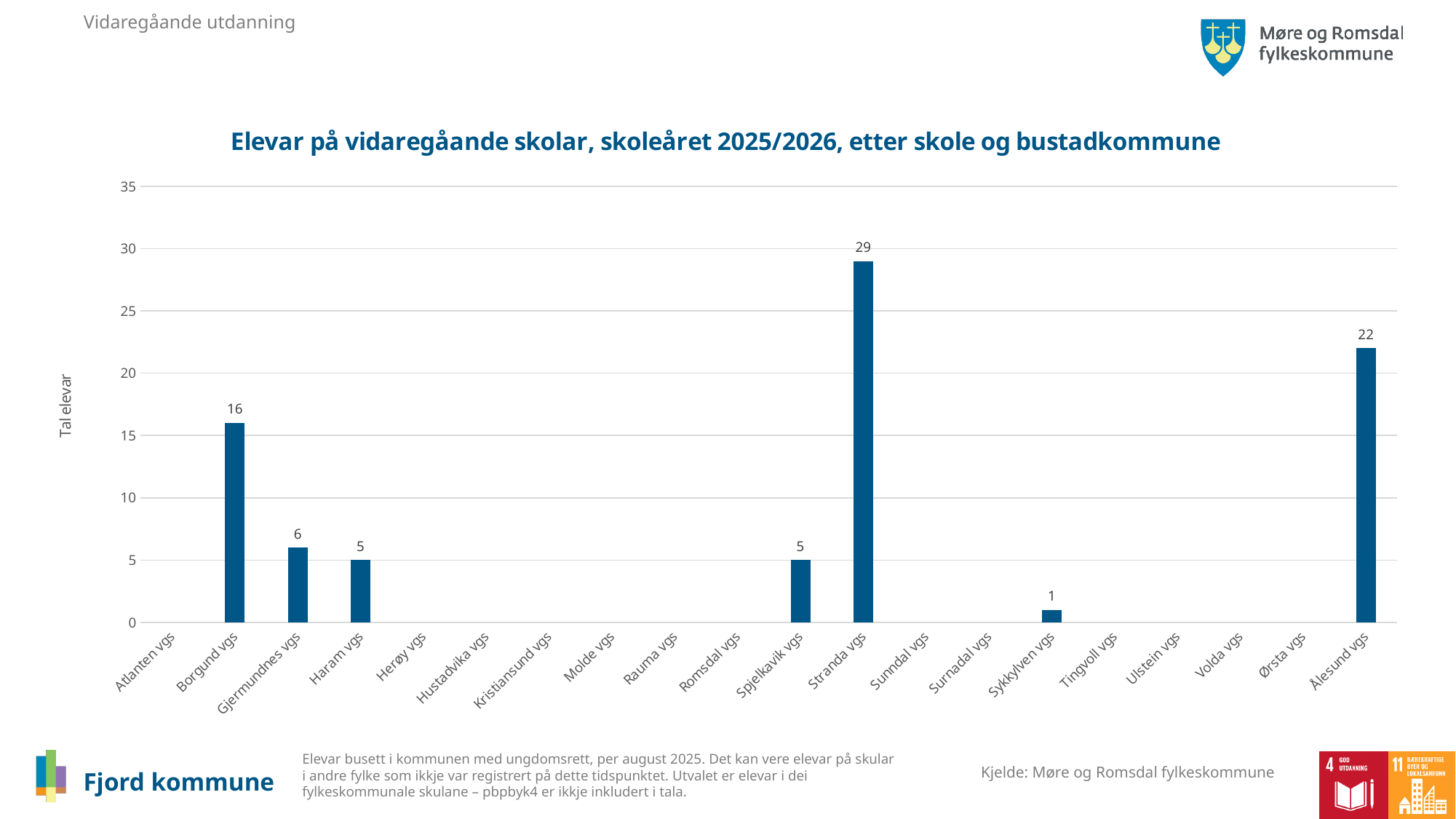
What kind of chart is shown on the slide? Bar chart How many students are shown for Stranda vgs? 29 Which school has the highest number of students? Stranda vgs What is the difference between the values for Stranda vgs and Ålesund vgs? 7 What is the difference between the values for Borgund vgs and Gjermundnes vgs? 10 What is the value for Ålesund vgs? 22 How many schools are listed on the x axis? 20 Among the schools with a labelled bar, which has the lowest value? Sykkylven vgs What is the value for Sykkylven vgs? 1 Which is larger, the value for Borgund vgs or the value for Ålesund vgs? Ålesund vgs What is the value for Borgund vgs? 16 What is the label of the y axis? Tal elevar